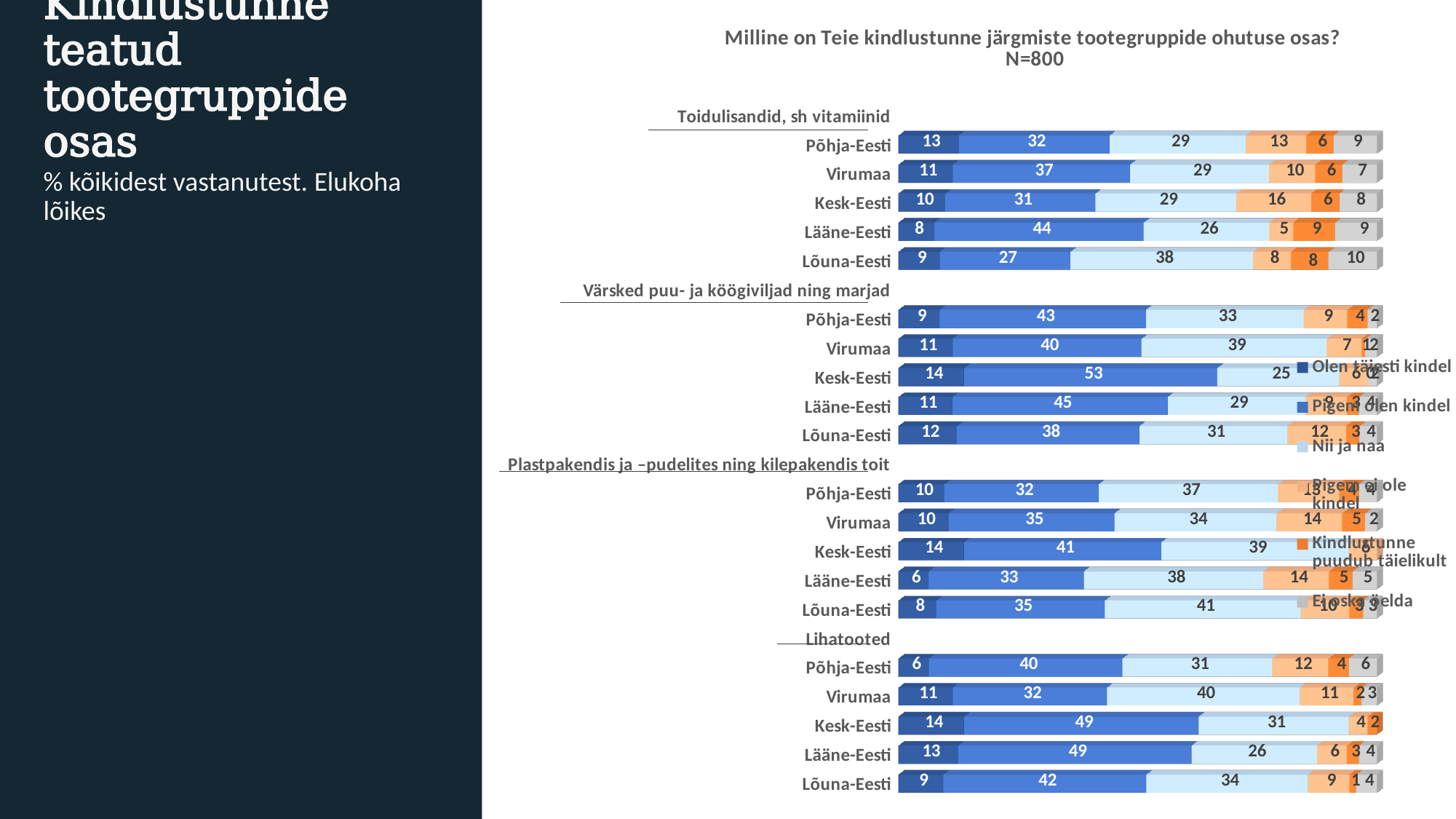
How many regions are shown within each product group? 5 In the Toidulisandid, sh vitamiinid group, what is the difference between the 'Pigem olen kindel' values for Lääne-Eesti and Lõuna-Eesti? 17 In the Toidulisandid, sh vitamiinid group, which region has the highest 'Nii ja naa' value? Lõuna-Eesti What type of chart is shown on the slide? bar chart What sample size (N) is stated in the chart title? N=800 In the Toidulisandid, sh vitamiinid group, what is the 'Pigem olen kindel' value for Lääne-Eesti? 44 In the Lihatooted group, which has the larger 'Olen täiesti kindel' value, Kesk-Eesti or Põhja-Eesti? Kesk-Eesti In the Plastpakendis ja –pudelites ning kilepakendis toit group, what is the 'Olen täiesti kindel' value for Lääne-Eesti? 6 In the Lihatooted group, what is the 'Nii ja naa' value for Virumaa? 40 In the Värsked puu- ja köögiviljad ning marjad group, what is the 'Pigem olen kindel' value for Kesk-Eesti? 53 How many series does the chart legend list? 6 In the Lihatooted group, which region has the lowest 'Olen täiesti kindel' value? Põhja-Eesti